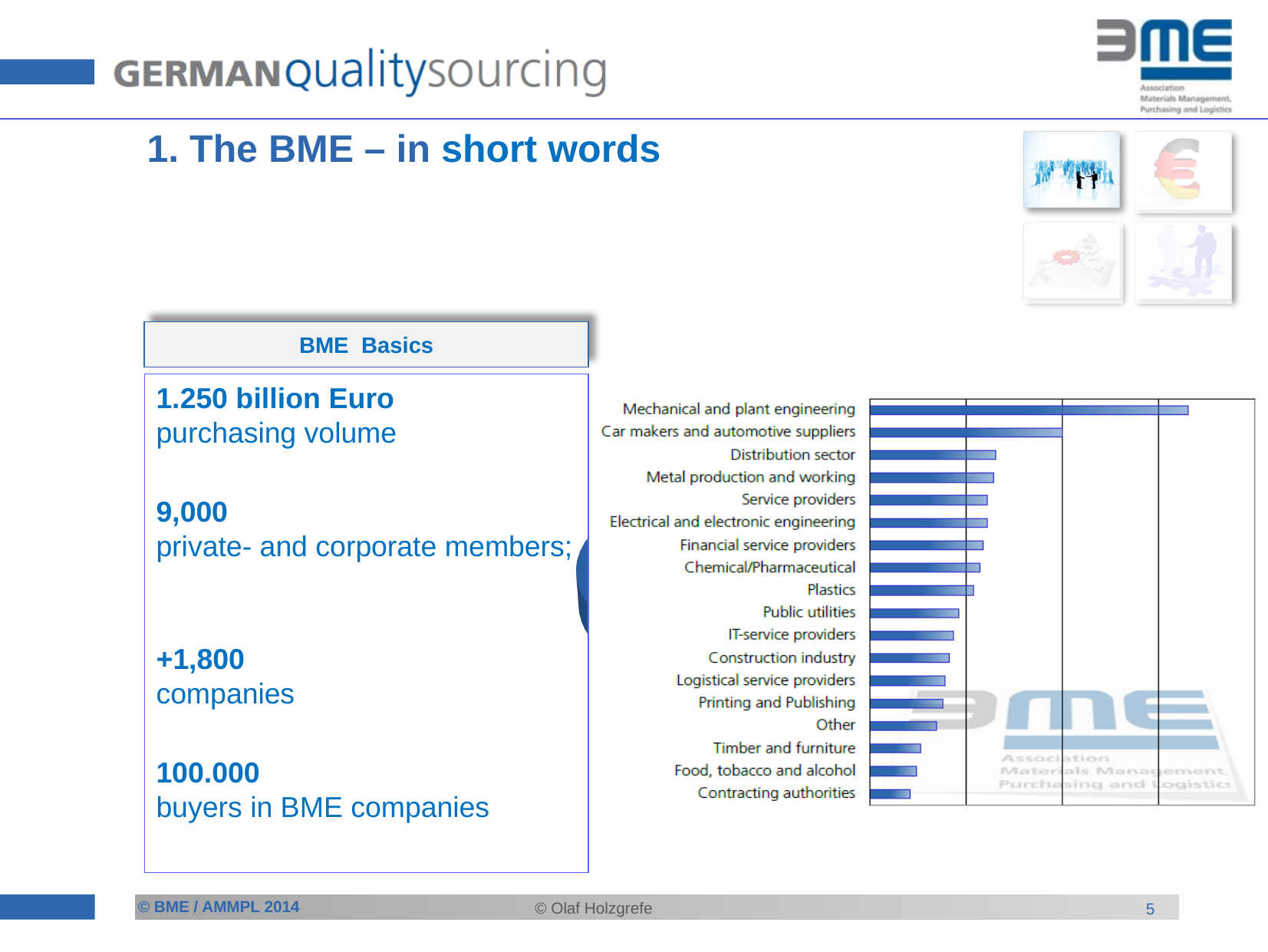
Which category is listed at the top of the bar chart? Mechanical and plant engineering Which has the larger value: Mechanical and plant engineering or Car makers and automotive suppliers? Mechanical and plant engineering Do the bar lengths increase or decrease going from the top category to the bottom category? Decrease How many categories are plotted in the bar chart? 18 Which has the larger value: Public utilities or Food, tobacco and alcohol? Public utilities Which has the larger value: Plastics or Contracting authorities? Plastics Which category has the shortest bar in the chart? Contracting authorities Which category has the longest bar in the chart? Mechanical and plant engineering What colour are the bars in the chart? Blue What kind of chart is shown on the slide? Bar chart